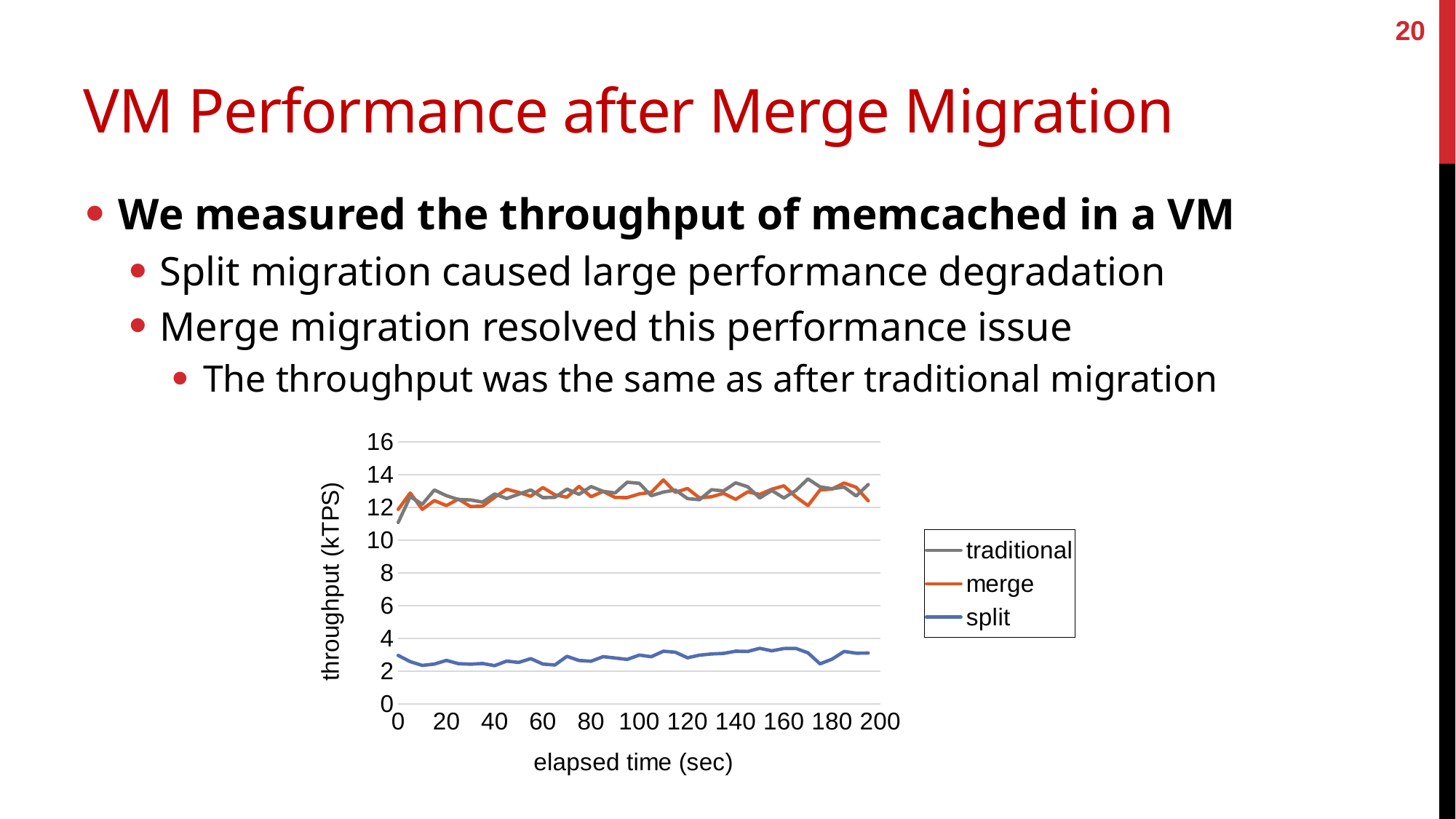
Is the throughput of the split series at 100 sec greater or less than 4? less Is the throughput of the split series at 20 sec greater or less than 2? greater Is the throughput of the traditional series at 100 sec greater or less than 10? greater Which series has the lowest throughput throughout the chart? split How many series does the chart's legend list? 3 What kind of chart is shown on the slide? line chart What are the series names listed in the chart's legend? traditional, merge, split At 100 sec, which series has the higher throughput, merge or split? merge What is the label of the chart's vertical axis? throughput (kTPS)